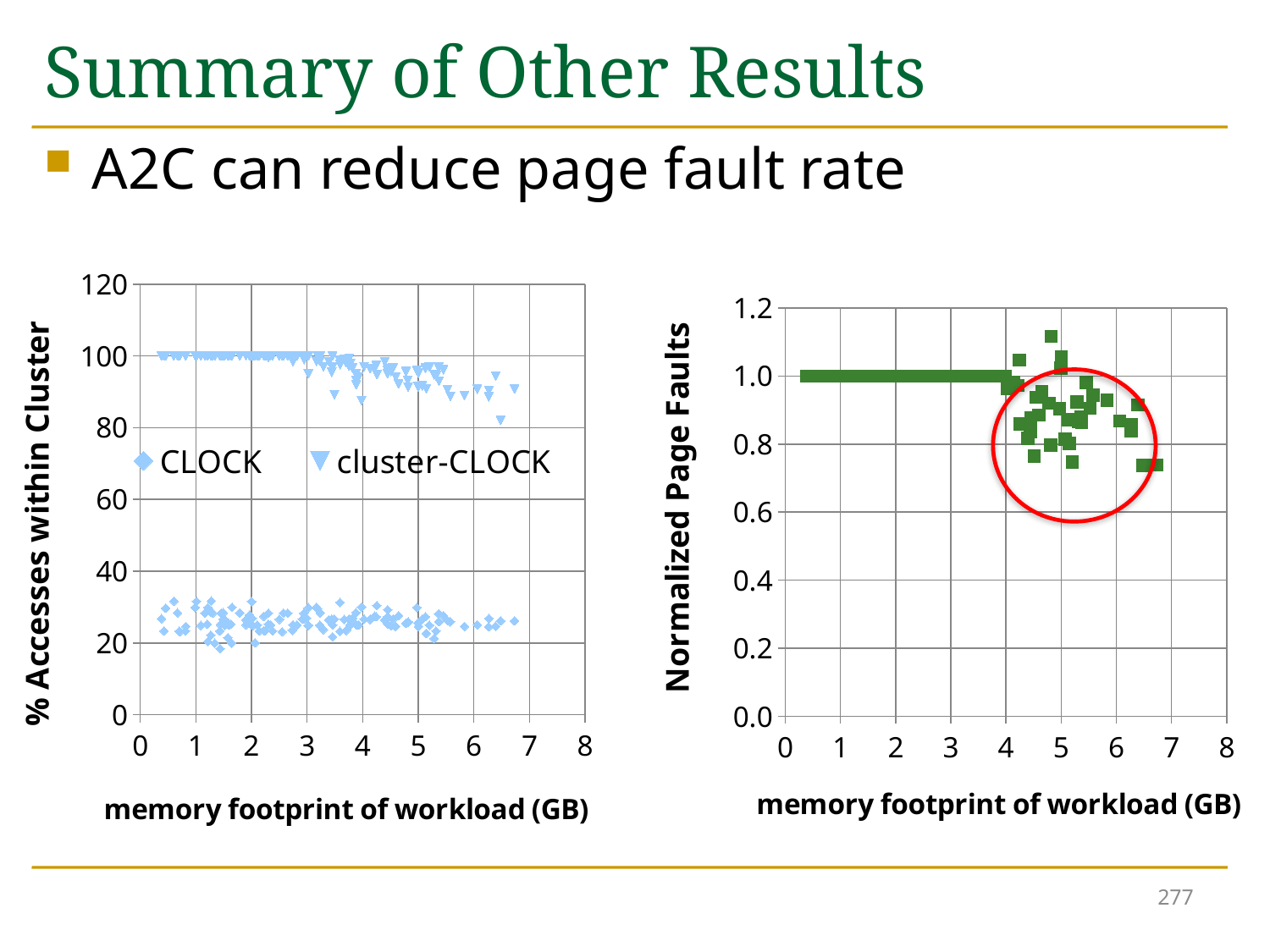
In the right chart ('Normalized Page Faults'), are the values for memory footprints between 4 and 7 GB greater or less than 0.6? greater In the left chart ('% Accesses within Cluster'), what is the maximum value shown on the y-axis? 120 In the left chart ('% Accesses within Cluster'), are the CLOCK values greater or less than 40? less What kind of chart is the left chart, with y-axis '% Accesses within Cluster'? scatter chart In the right chart ('Normalized Page Faults'), are the values for memory footprints below 4 GB greater or less than 0.8? greater What is the x-axis label of the left chart ('% Accesses within Cluster')? memory footprint of workload (GB) What is the y-axis label of the right chart? Normalized Page Faults What kind of chart is the right chart, with y-axis 'Normalized Page Faults'? scatter chart In the right chart ('Normalized Page Faults'), do the values generally rise or fall as the memory footprint increases beyond 4 GB? fall In the left chart ('% Accesses within Cluster'), which series has the higher values, CLOCK or cluster-CLOCK? cluster-CLOCK In the left chart ('% Accesses within Cluster'), how many series does the legend list? 2